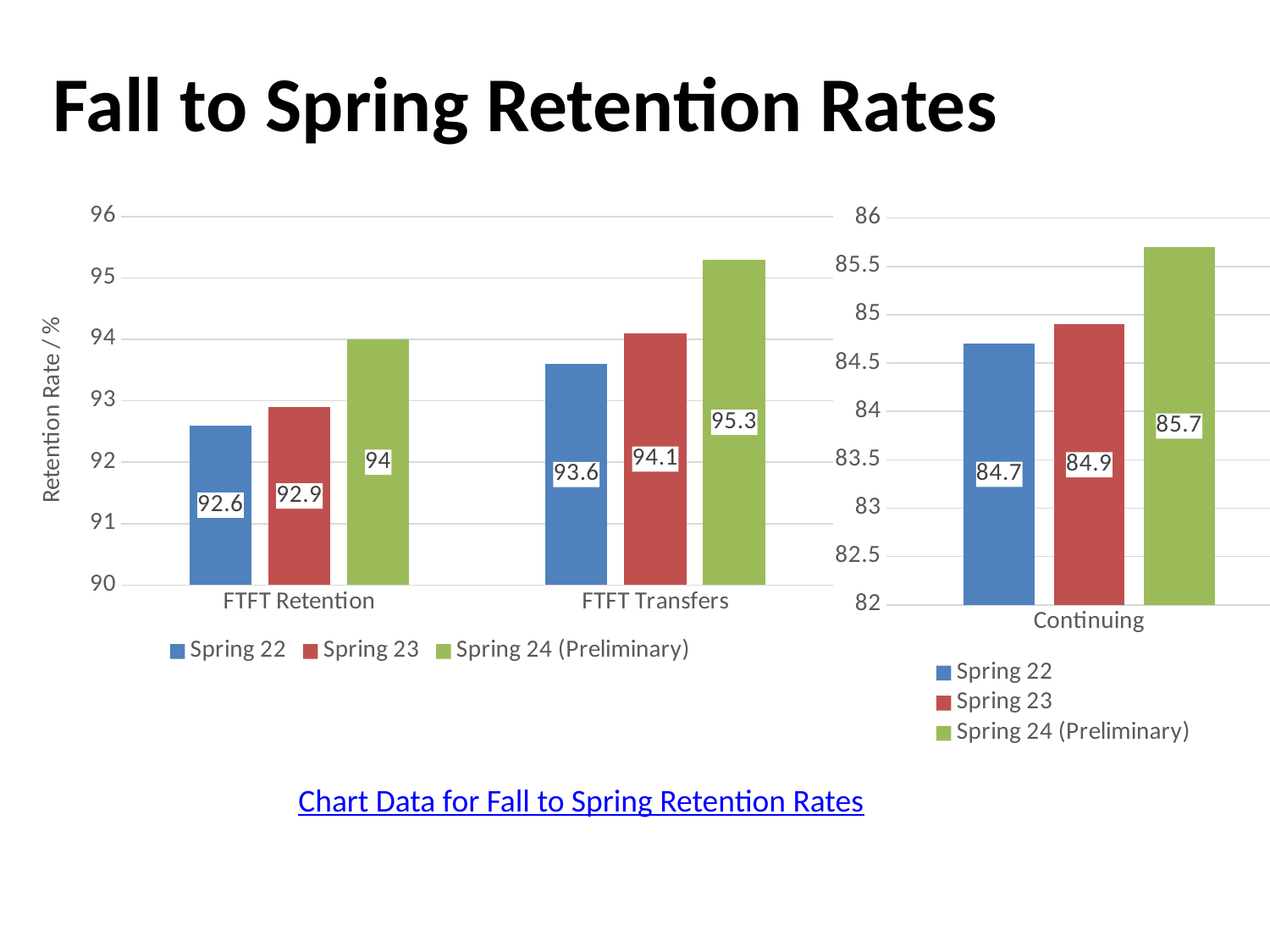
What kind of chart is the left chart? bar chart In the left chart, which series has the highest value for FTFT Retention? Spring 24 (Preliminary) How many categories are shown on the x axis of the left chart? 2 How many series does the legend of the right chart list? 3 In the left chart, what is the difference between the Spring 24 (Preliminary) and Spring 22 values for FTFT Transfers? 1.7 In the left chart, is the Spring 22 value for FTFT Transfers greater or less than 93? greater In the right chart, what is the difference between the Spring 24 (Preliminary) and Spring 23 values for Continuing? 0.8 In the left chart, what is the Spring 22 value for FTFT Retention? 92.6 In the left chart, which is larger: the Spring 23 value for FTFT Retention or the Spring 23 value for FTFT Transfers? FTFT Transfers In the right chart, which series has the lowest value for Continuing? Spring 22 In the right chart, what is the Spring 23 value for Continuing? 84.9 In the left chart, what is the Spring 24 (Preliminary) value for FTFT Transfers? 95.3